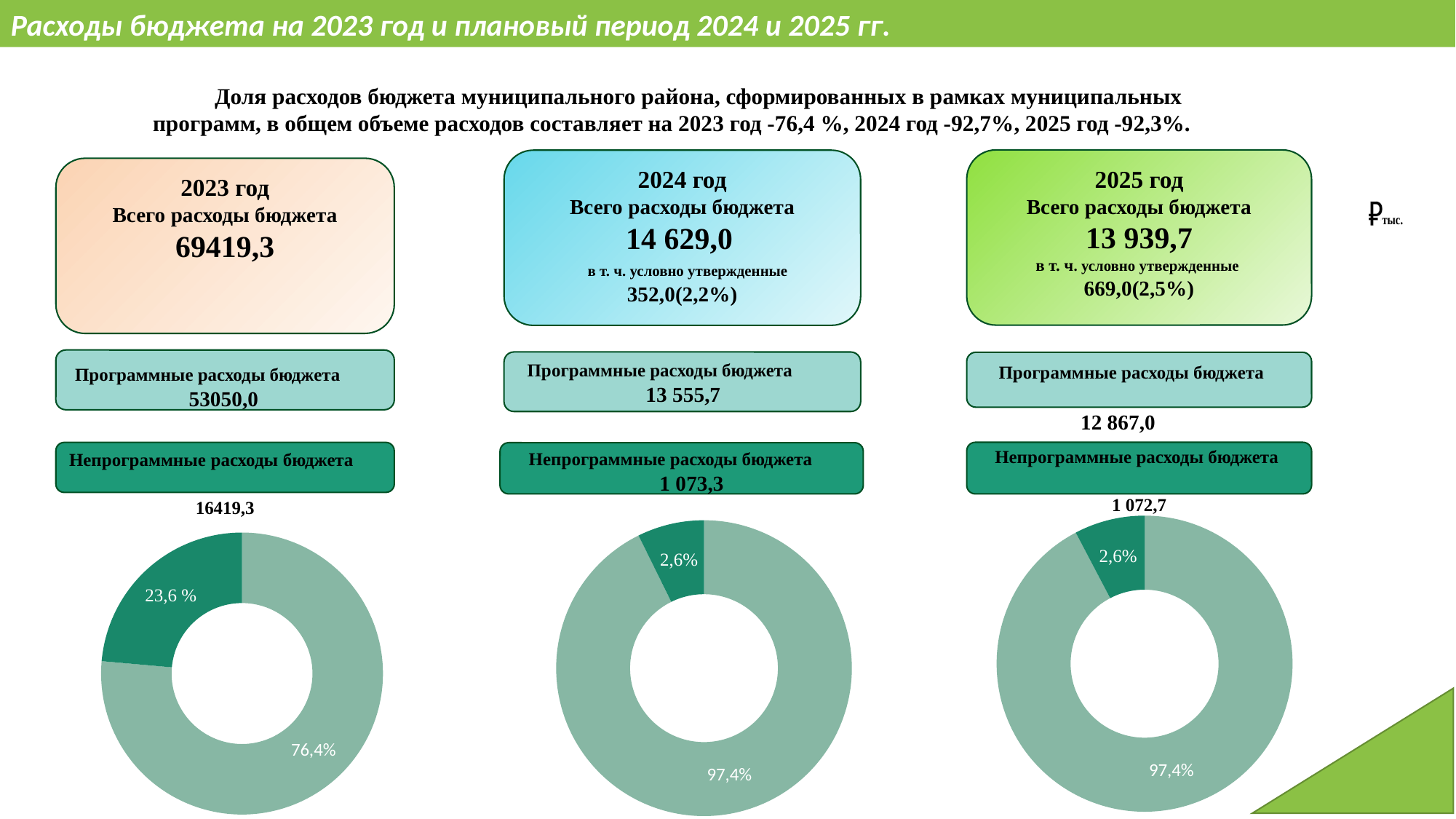
How many donut charts are shown on the slide? 3 In the left donut chart (2023 год), which slice is larger: the light-green one or the dark-green one? The light-green one In the left donut chart (2023 год), what share is shown for the dark-green slice? 23,6 % In the middle donut chart (2024 год), what share is shown for the dark-green slice? 2,6% What kind of chart is used for the 2023 year (left chart)? Donut (pie) chart In the left donut chart (2023 год), what is the difference between the two slice shares (76,4% and 23,6 %)? 52,8% Which year's donut chart shows the largest dark-green (non-program) share? 2023 год In the right donut chart (2025 год), what share is shown for the dark-green slice? 2,6% In the middle donut chart (2024 год), what share is shown for the light-green slice? 97,4% How many slices does each donut chart on the slide have? 2 In the right donut chart (2025 год), what share is shown for the light-green slice? 97,4% In the left donut chart (2023 год), what share is shown for the larger light-green slice? 76,4%